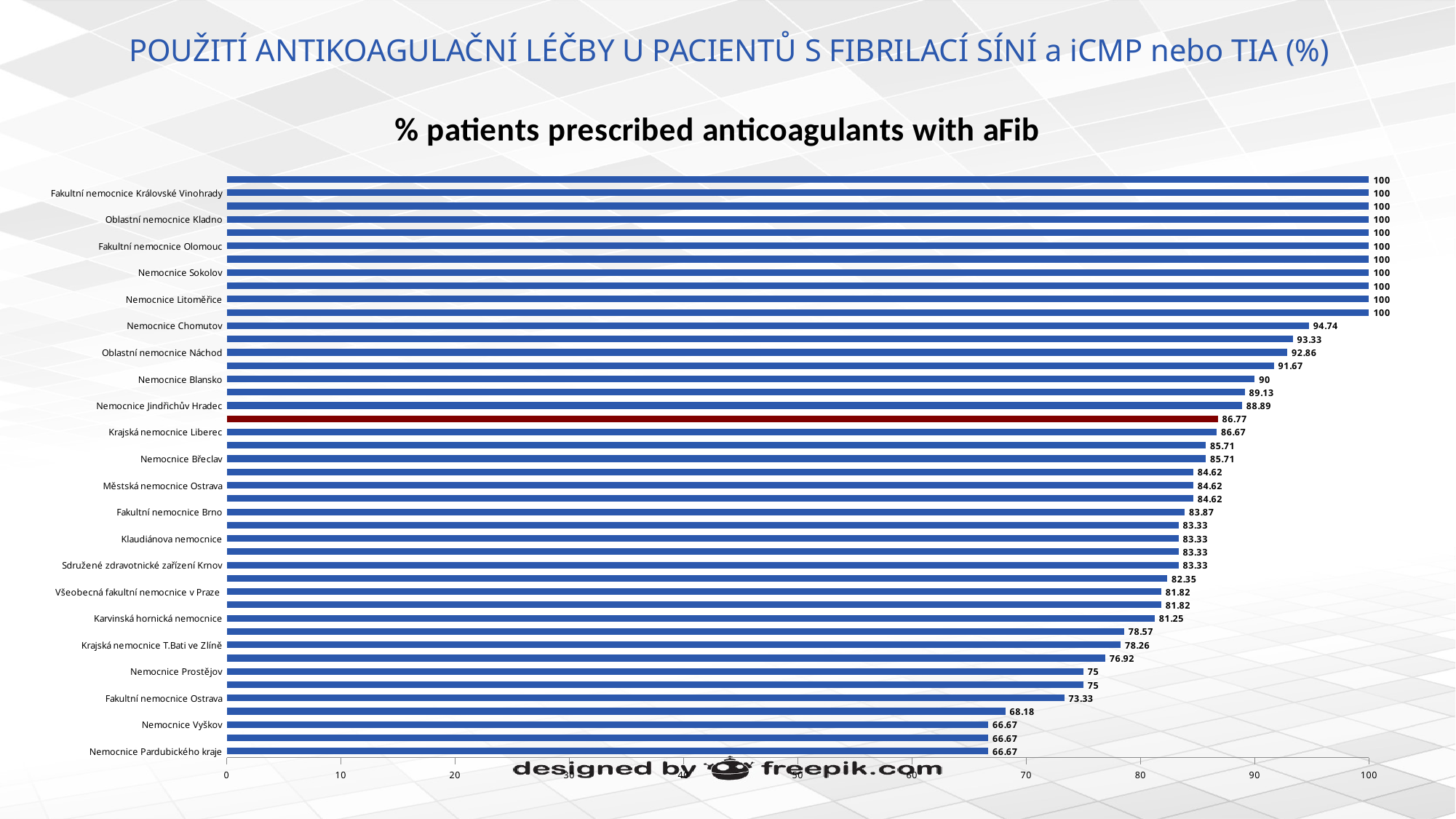
What is the value for Fakultní nemocnice Ostrava? 73.33 What is the title of the chart? % patients prescribed anticoagulants with aFib What kind of chart is shown? Bar chart What is the value for Nemocnice Blansko? 90 Is the value for Karvinská hornická nemocnice greater or less than 80? greater What is the value for Nemocnice Pardubického kraje? 66.67 What is the difference between the values for Nemocnice Chomutov and Nemocnice Prostějov? 19.74 What is the value for Nemocnice Sokolov? 100 What is the value for Nemocnice Chomutov? 94.74 What is the value shown on the single red bar? 86.77 What is the value for Krajská nemocnice T.Bati ve Zlíně? 78.26 Which has a higher value, Oblastní nemocnice Náchod or Fakultní nemocnice Brno? Oblastní nemocnice Náchod